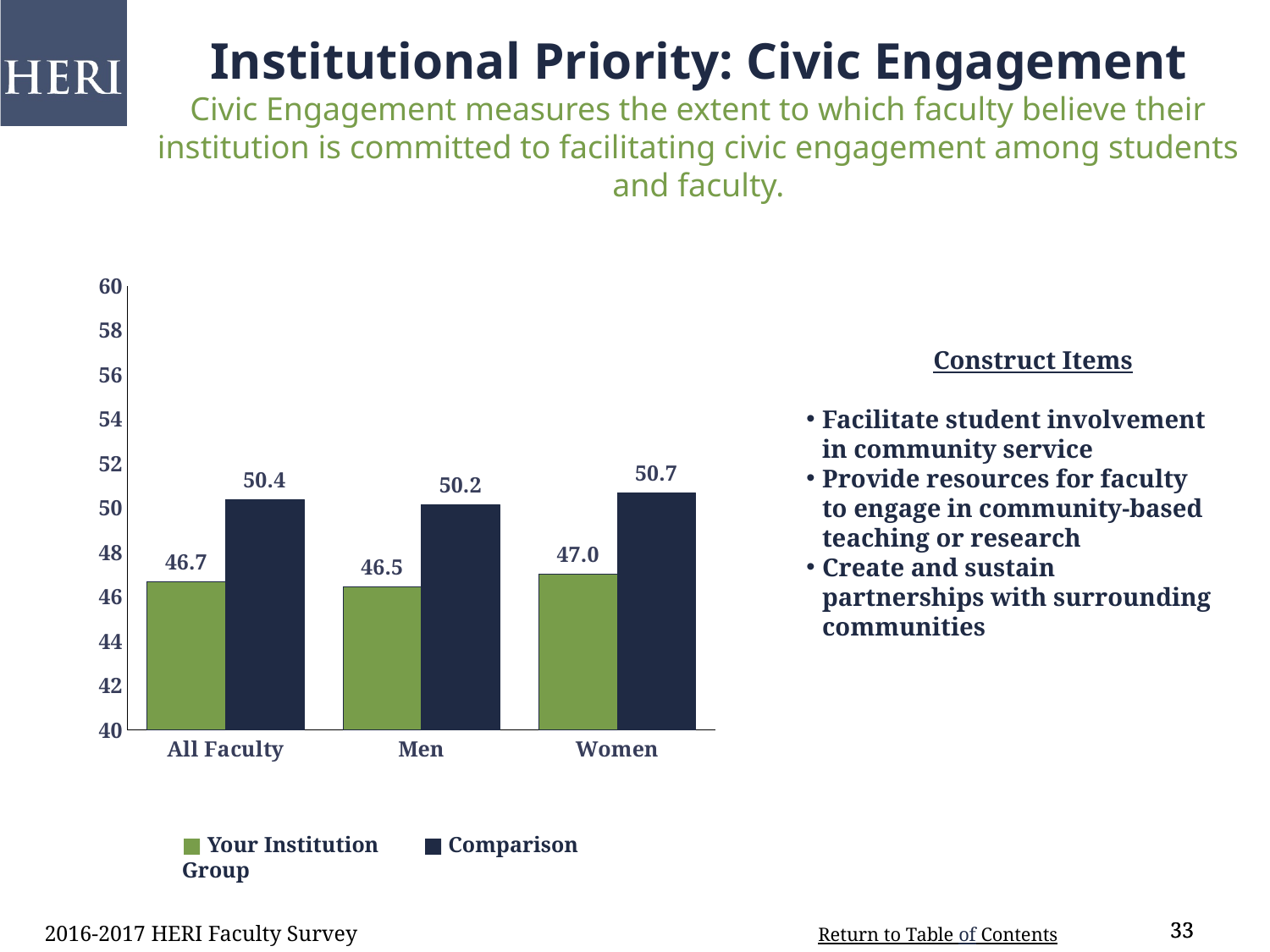
What kind of chart is shown on the slide? bar chart What is the value for Your Institution for All Faculty? 46.7 Which category has the highest Comparison Group value? Women What is the Comparison Group value for Men? 50.2 For Women, which is larger: Your Institution or Comparison Group? Comparison Group How many categories are shown on the x axis? 3 Which category has the lowest Your Institution value? Men Is the Your Institution value for Women greater or less than 48? less What is the Your Institution value for Men? 46.5 How many series does the legend list? 2 What is the Comparison Group value for Women? 50.7 What is the difference between the Comparison Group and Your Institution values for All Faculty? 3.7